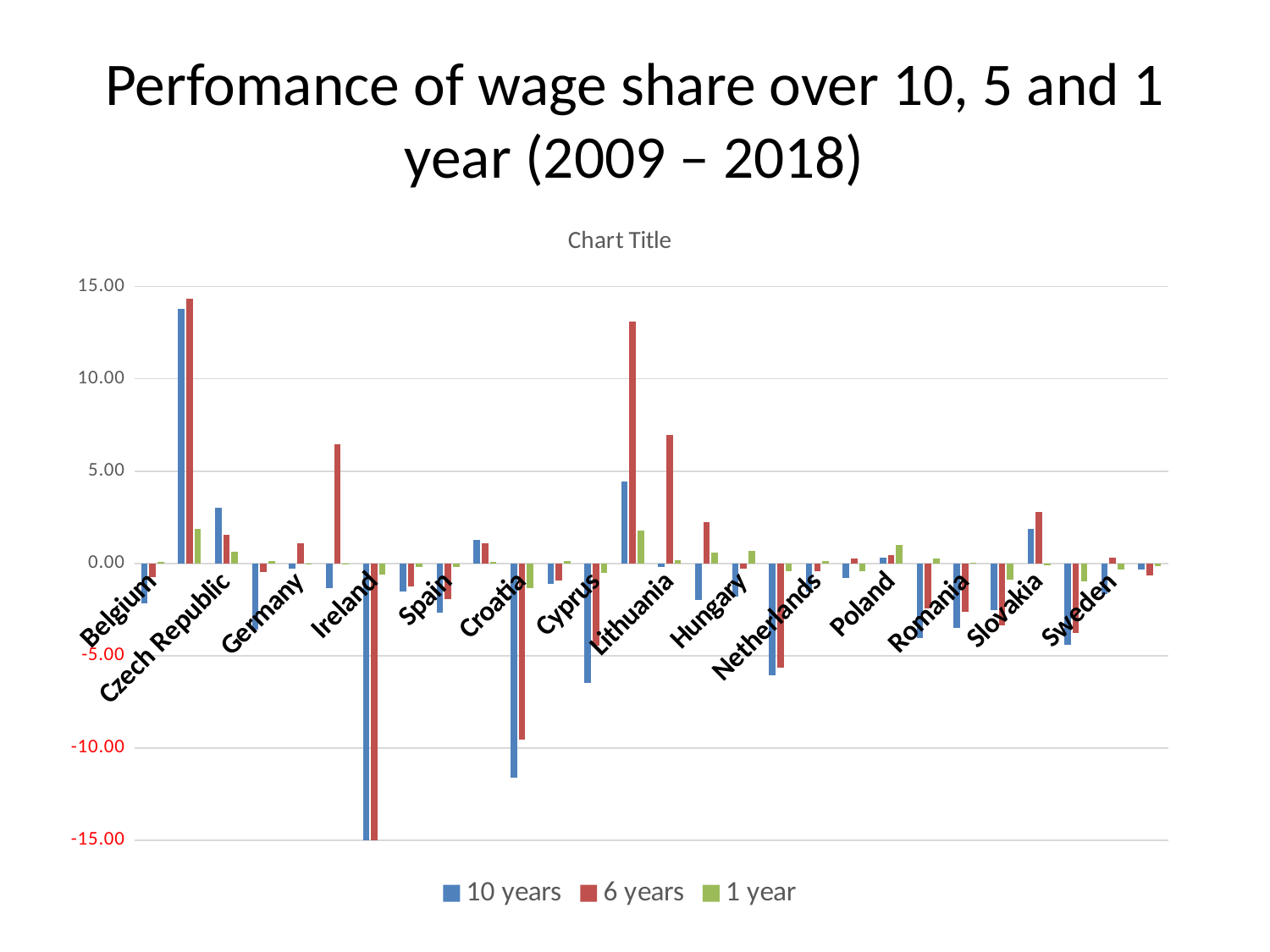
What kind of chart is shown on the slide? bar chart For Croatia, which series has the lowest value? 10 years Is the 10 years value for Ireland greater or less than -10.00? less For Lithuania, which series has the highest value? 6 years How many series does the legend list? 3 Is the 10 years value for Croatia greater or less than -10.00? less Is the 10 years value for Cyprus greater or less than -5.00? less What are the three series named in the legend? 10 years, 6 years, 1 year Which colour represents the 10 years series? blue For Slovakia, which is larger: the 10 years value or the 6 years value? 6 years